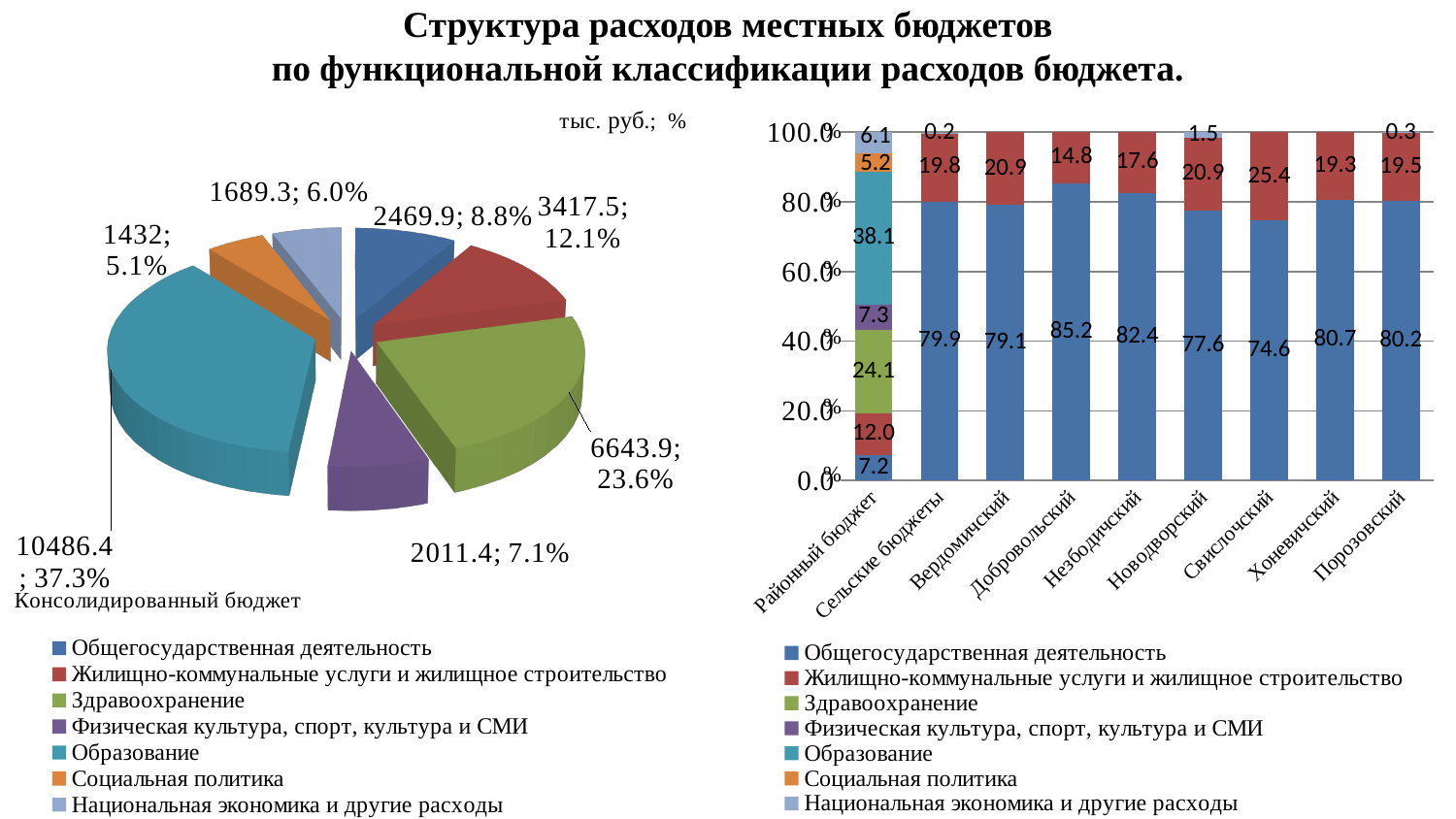
In the pie chart on the left, which category has the largest slice? Образование In the bar chart on the right, which is larger: the Общегосударственная деятельность value for Незбодичский or for Новодворский? Незбодичский In the pie chart on the left, what is the value shown for Образование? 10486.4; 37.3% In the pie chart on the left, what share of the pie does Здравоохранение take? 23.6% In the bar chart on the right, how many categories are shown on the x axis? 9 In the pie chart on the left, what is the difference between the values for Здравоохранение and Жилищно-коммунальные услуги и жилищное строительство? 3226.4 How many series does the legend of the bar chart on the right list? 7 In the bar chart on the right, what is the value of Образование for Районный бюджет? 38.1 In the bar chart on the right, what is the value of Общегосударственная деятельность for Добровольский? 85.2 In the pie chart on the left, which category has the smallest slice? Социальная политика In the bar chart on the right, which category has the highest value for Жилищно-коммунальные услуги и жилищное строительство? Свислочский What kind of chart is the chart on the right? Stacked bar chart